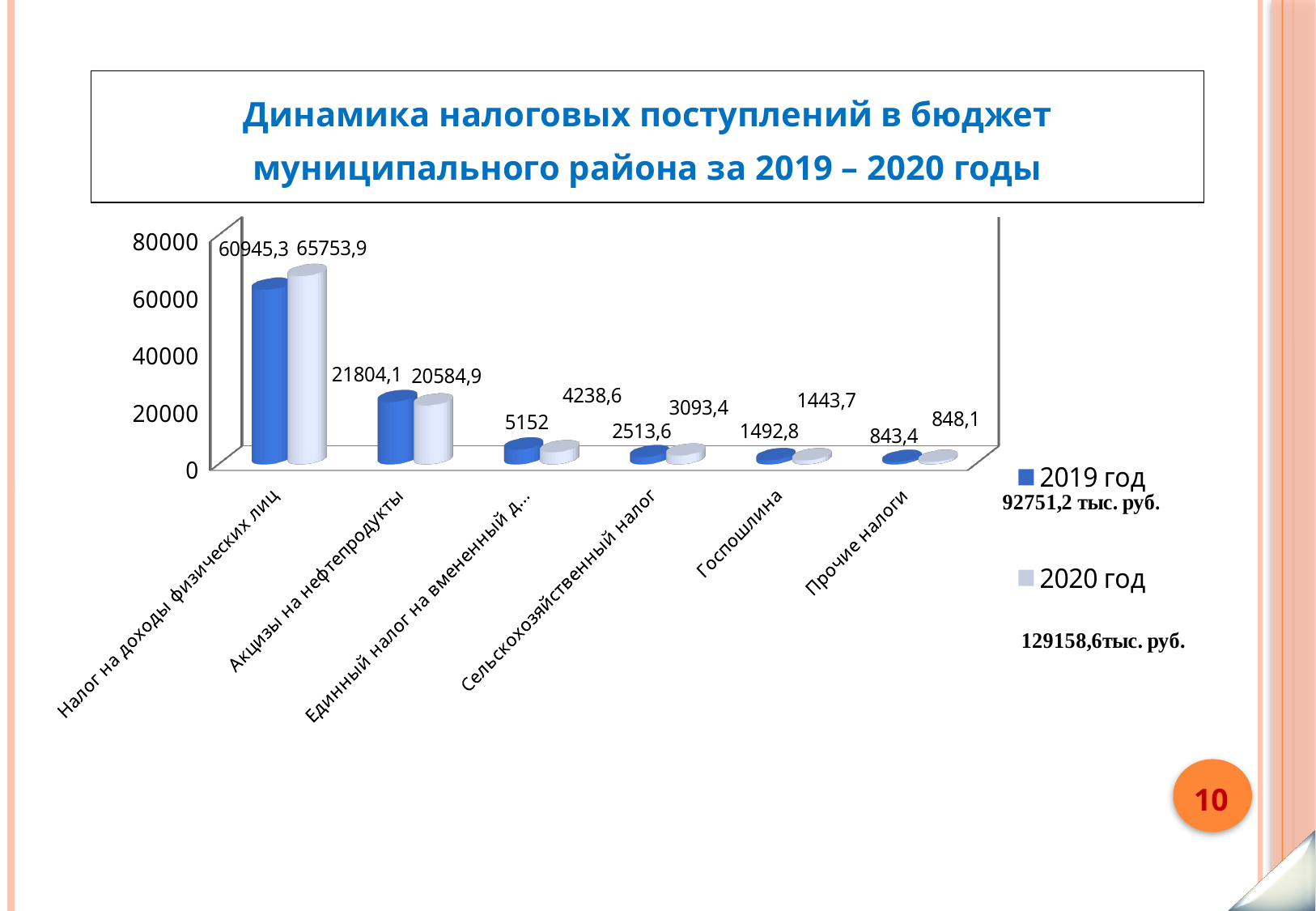
Which category has the lowest 2019 год value? Прочие налоги What is the 2019 год value for Госпошлина? 1492,8 What is the difference between the 2019 год and 2020 год values for Акцизы на нефтепродукты? 1219,2 How many series does the legend list? 2 What is the 2020 год value for Сельскохозяйственный налог? 3093,4 How many categories are shown on the x axis? 6 Which category has the highest 2020 год value? Налог на доходы физических лиц What is the 2020 год value for Акцизы на нефтепродукты? 20584,9 For Сельскохозяйственный налог, which year has the larger value, 2019 год or 2020 год? 2020 год What is the 2019 год value for Налог на доходы физических лиц? 60945,3 What is the difference between the 2020 год and 2019 год values for Налог на доходы физических лиц? 4808,6 What kind of chart is shown on the slide? Bar chart